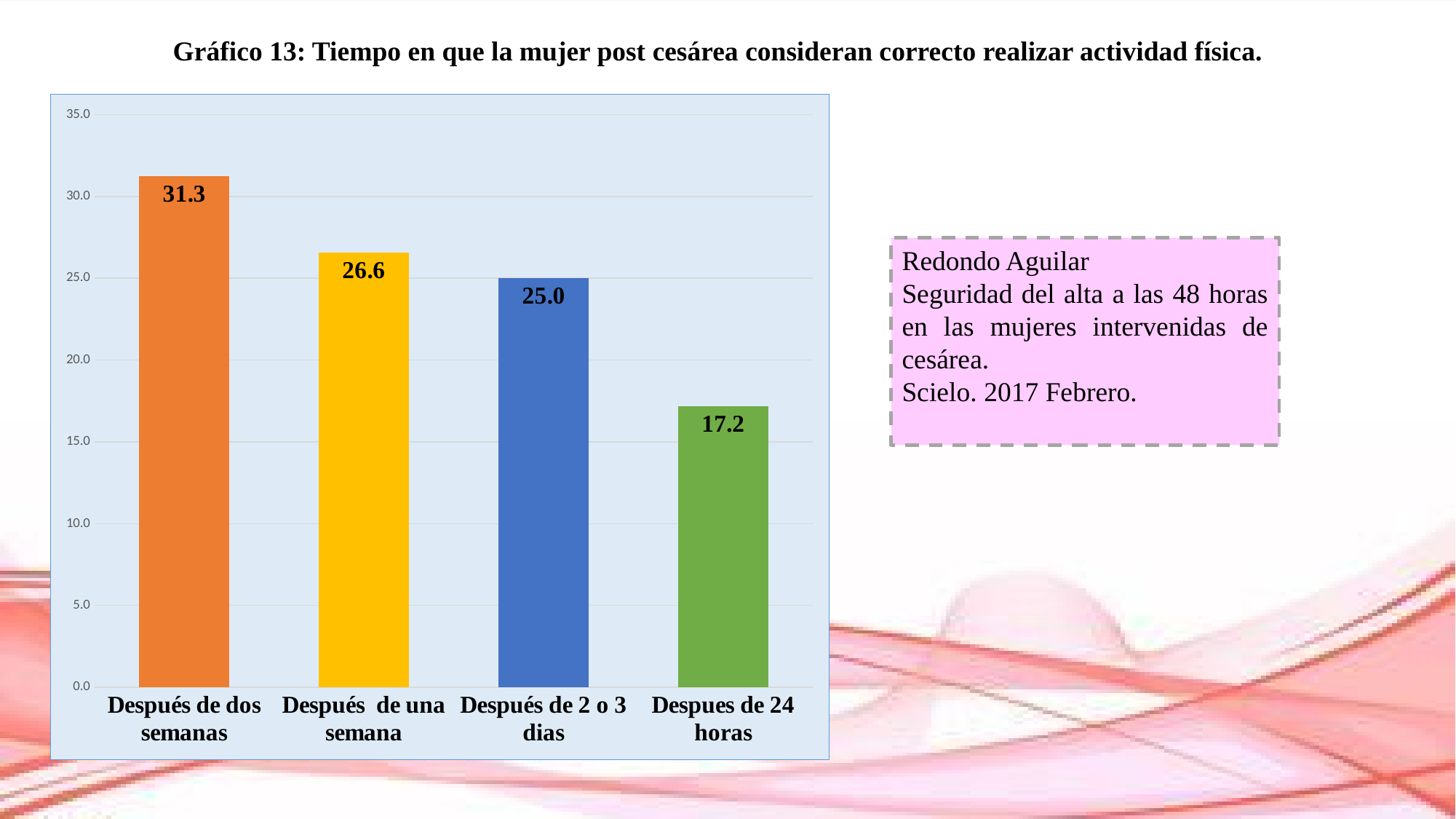
Which category has the lowest value? Despues de 24 horas What is the value for "Después de 2 o 3 dias"? 25.0 Which category has the highest value? Después de dos semanas What kind of chart is shown on the slide? bar chart What is the value for "Después de dos semanas"? 31.3 Which is larger, the value for "Después de una semana" or "Después de 2 o 3 dias"? Después de una semana What is the value for "Despues de 24 horas"? 17.2 Is the value for "Despues de 24 horas" greater or less than 20.0? less What is the difference between the values for "Después de dos semanas" and "Despues de 24 horas"? 14.1 How many categories are shown in the chart? 4 What is the value for "Después de una semana"? 26.6 Do the values rise or fall from left to right along the x axis? fall